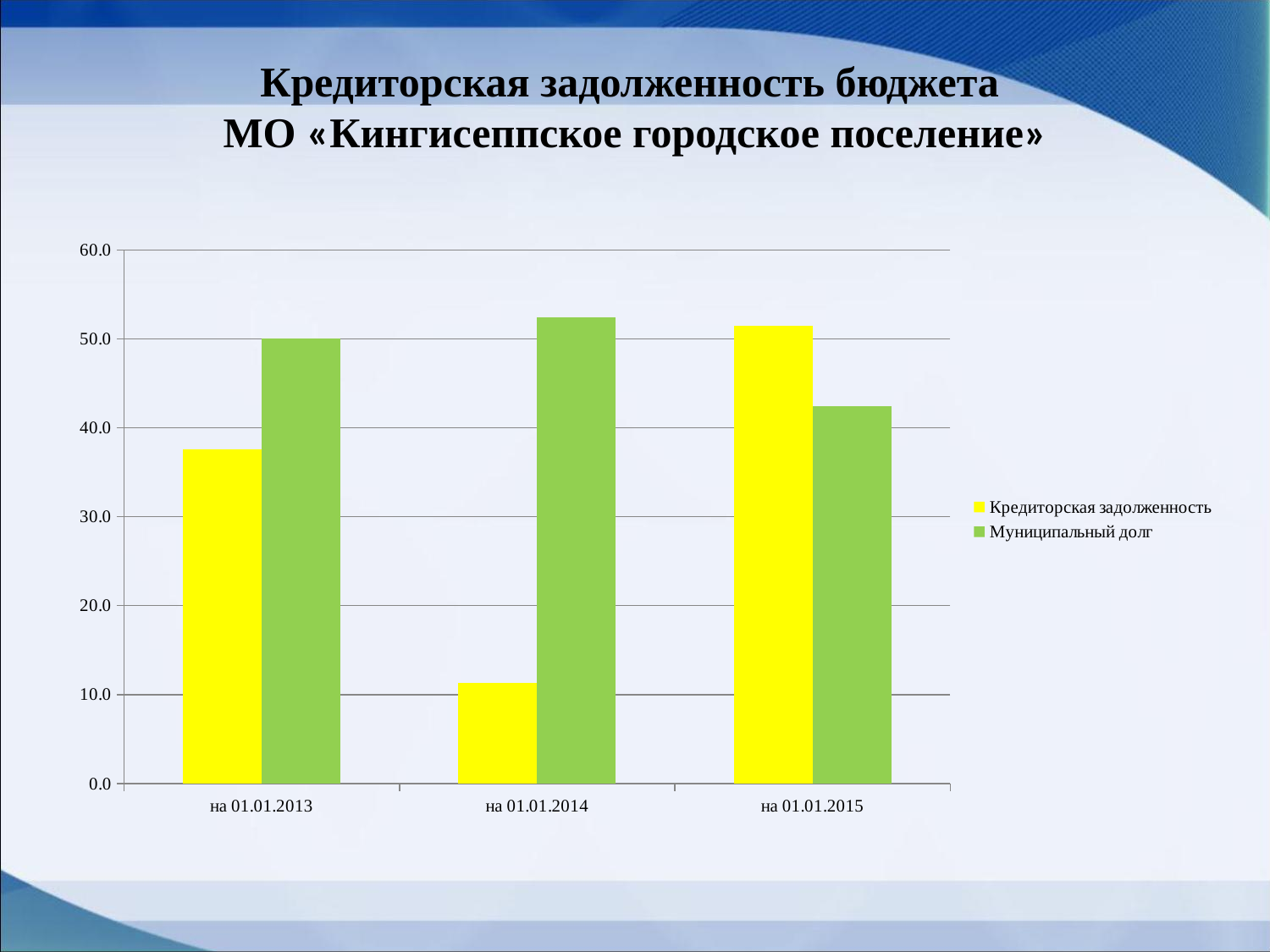
On which date is Кредиторская задолженность lowest? на 01.01.2014 How many dates (categories) are shown on the x axis? 3 How many series does the legend list? 2 On 01.01.2015, which is larger: Кредиторская задолженность or Муниципальный долг? Кредиторская задолженность Is the value of Кредиторская задолженность on 01.01.2013 greater or less than 40.0? less Which colour represents Муниципальный долг in the chart? green What kind of chart is shown on the slide? bar chart On which date is Муниципальный долг lowest? на 01.01.2015 On which date is Кредиторская задолженность highest? на 01.01.2015 On 01.01.2013, which is larger: Кредиторская задолженность or Муниципальный долг? Муниципальный долг Is the value of Кредиторская задолженность on 01.01.2014 greater or less than 20.0? less Is the value of Муниципальный долг on 01.01.2015 greater or less than 40.0? greater